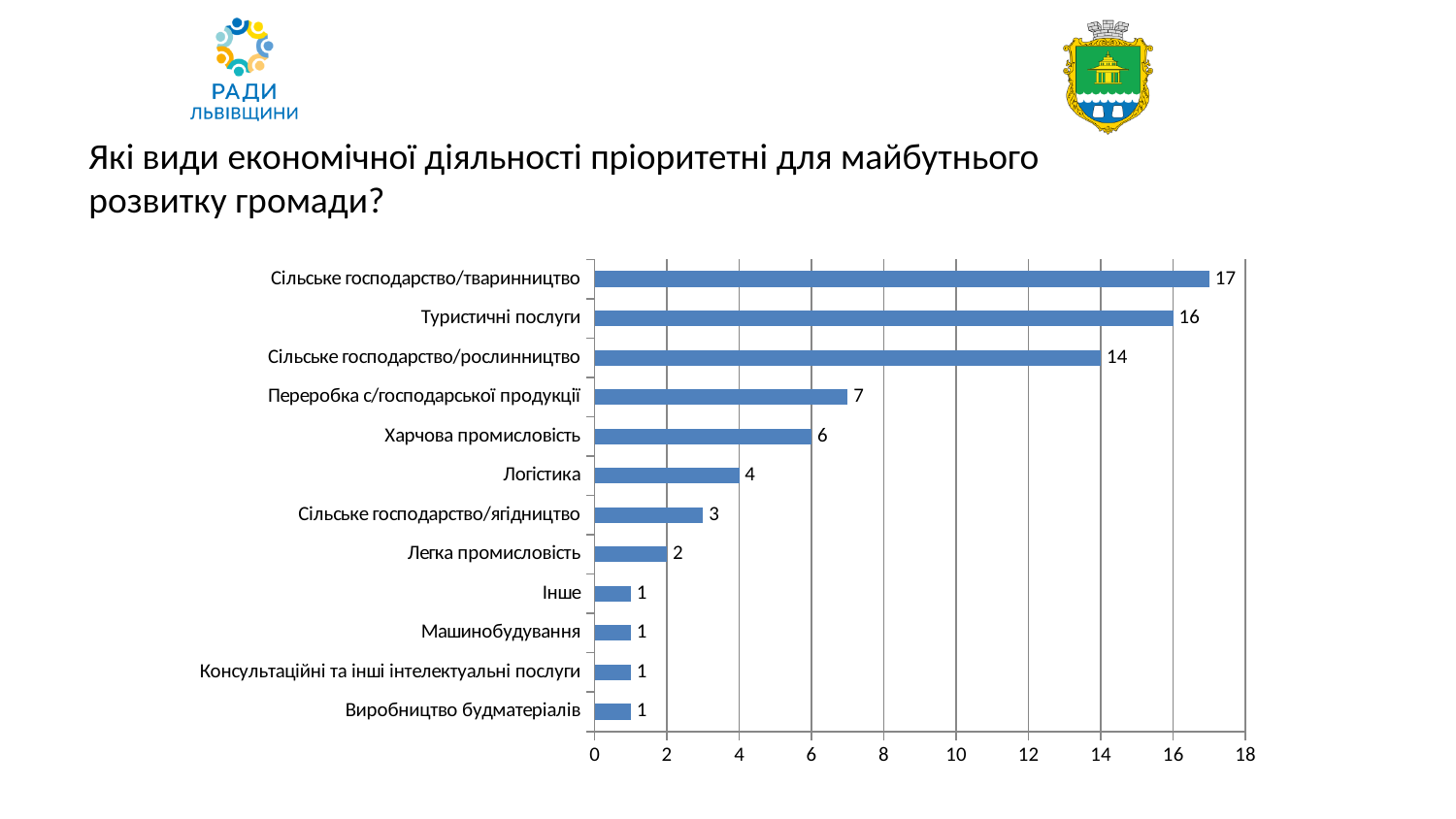
Is the value for Туристичні послуги greater or less than 10? greater What is the difference between Переробка с/господарської продукції and Логістика? 3 What is the value for Харчова промисловість? 6 How many categories are shown in the chart? 12 How many categories have a value of 1? 4 What is the difference between Сільське господарство/тваринництво and Сільське господарство/рослинництво? 3 Which is larger, Легка промисловість or Логістика? Логістика What is the highest value shown on the x axis? 18 What kind of chart is shown on the slide? bar chart What is the value for Туристичні послуги? 16 Which category has the highest value? Сільське господарство/тваринництво What is the value for Сільське господарство/ягідництво? 3